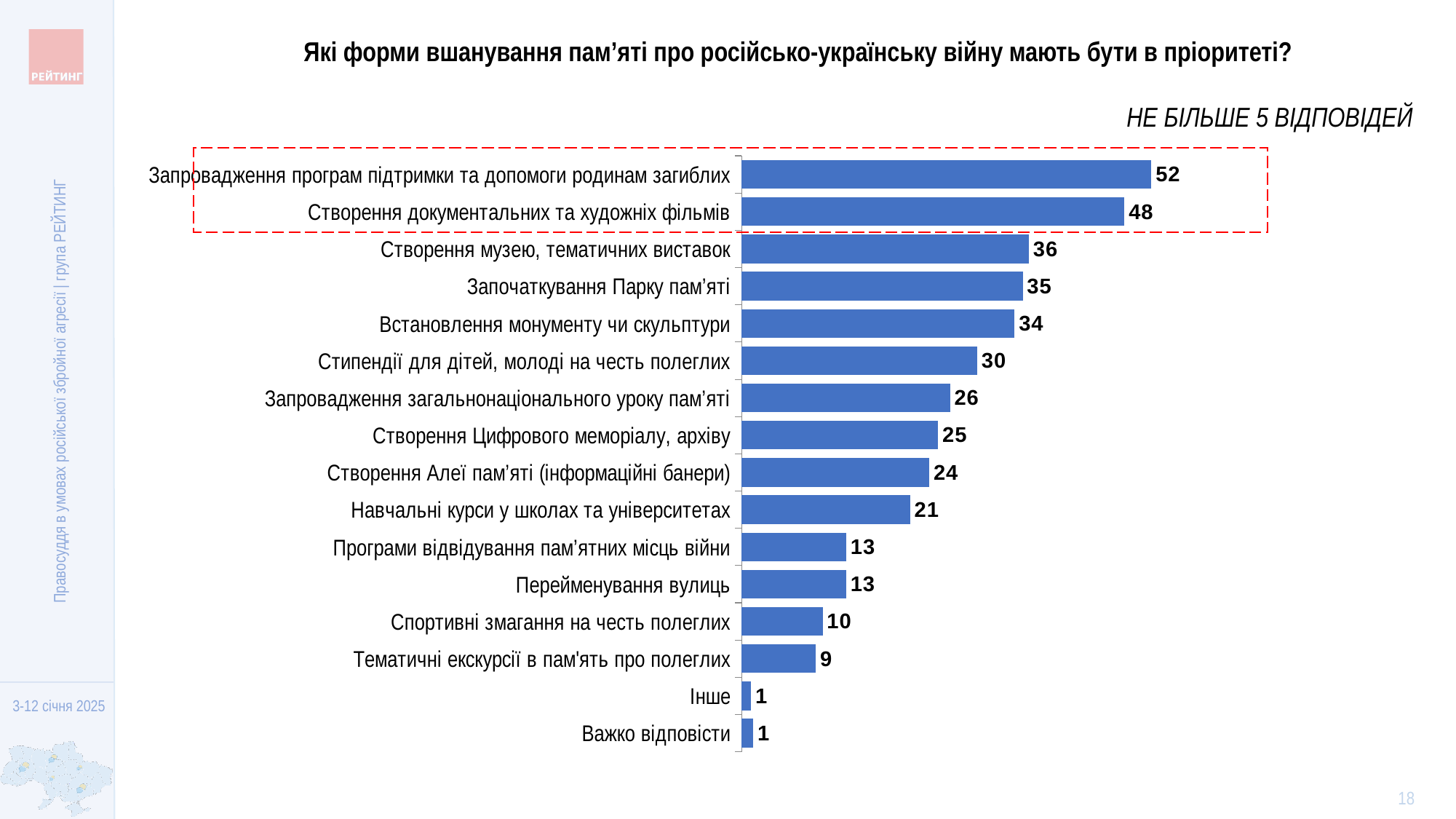
What is the title of the chart? Які форми вшанування пам'яті про російсько-українську війну мають бути в пріоритеті? What value is shown for "Перейменування вулиць"? 13 What value is shown for "Стипендії для дітей, молоді на честь полеглих"? 30 What value is shown for "Створення документальних та художніх фільмів"? 48 Which is larger: the value for "Спортивні змагання на честь полеглих" or the value for "Програми відвідування пам'ятних місць війни"? Програми відвідування пам'ятних місць війни What is the difference between the values for "Запровадження програм підтримки та допомоги родинам загиблих" and "Створення документальних та художніх фільмів"? 4 What is the difference between the values for "Створення музею, тематичних виставок" and "Навчальні курси у школах та університетах"? 15 Which is larger: the value for "Встановлення монументу чи скульптури" or the value for "Створення Цифрового меморіалу, архіву"? Встановлення монументу чи скульптури Which category has the highest value on the chart? Запровадження програм підтримки та допомоги родинам загиблих What kind of chart is shown on the slide? Bar chart How many categories are shown on the chart? 16 What value is shown for "Тематичні екскурсії в пам'ять про полеглих"? 9